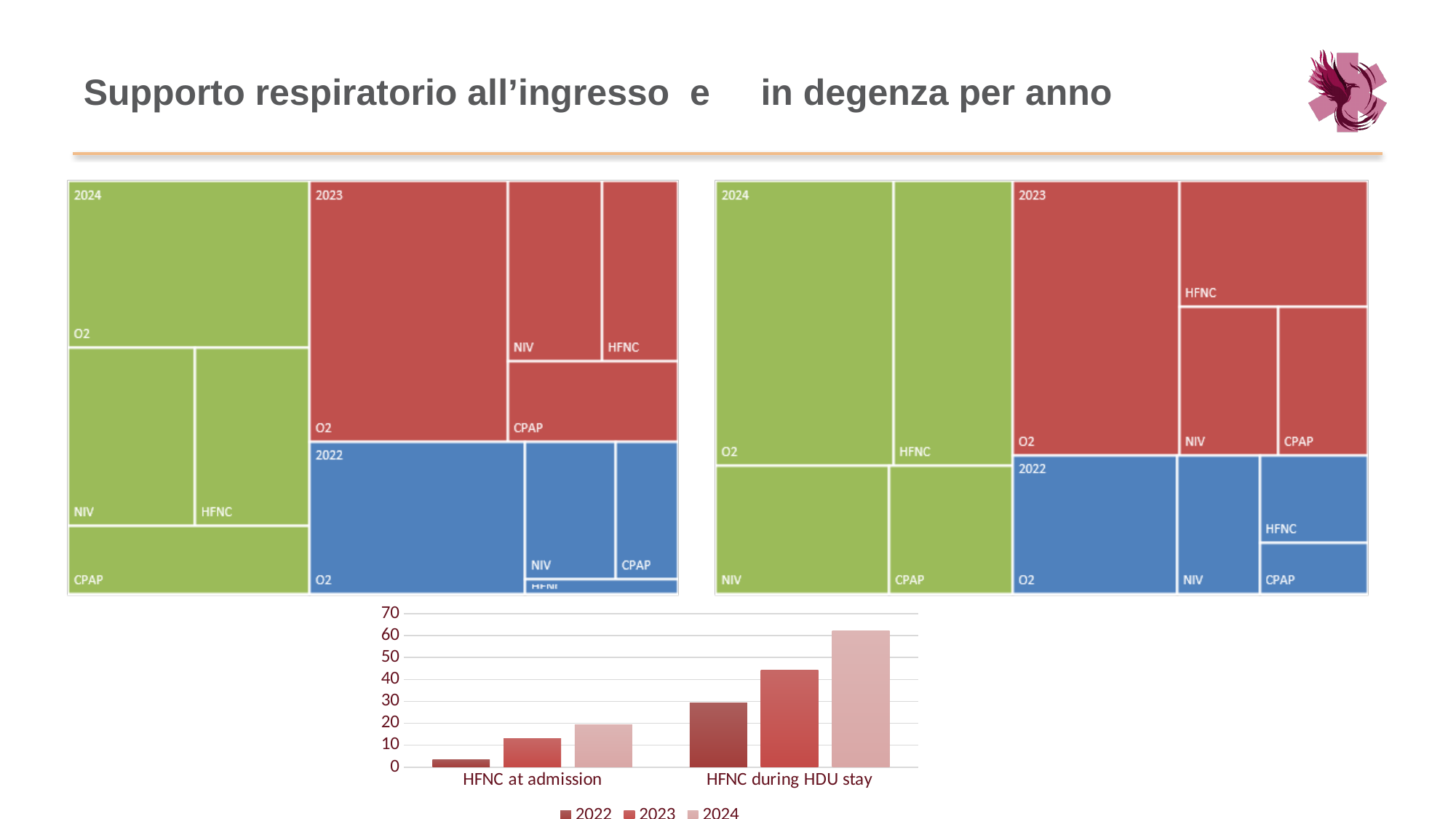
In the bottom bar chart, how many categories are shown on the x axis? 2 In the bottom bar chart, which is larger: the 2023 value for HFNC at admission or the 2022 value for HFNC during HDU stay? 2022 value for HFNC during HDU stay In the top-left treemap, which category occupies the largest tile within the 2024 group? O2 In the bottom bar chart, is the 2022 value for HFNC at admission greater or less than 10? less What kind of chart is the chart at the bottom of the slide? bar chart In the bottom bar chart, is the 2023 value for HFNC during HDU stay greater or less than 40? greater In the bottom bar chart, how many series does the legend list? 3 What kind of chart is the chart at the top left of the slide? treemap In the bottom bar chart, is the 2024 value for HFNC during HDU stay greater or less than 60? greater In the bottom bar chart, which year has the highest value for HFNC during HDU stay? 2024 In the bottom bar chart, which year has the lowest value for HFNC at admission? 2022 In the bottom bar chart, do the values for HFNC at admission rise or fall from 2022 to 2024? rise